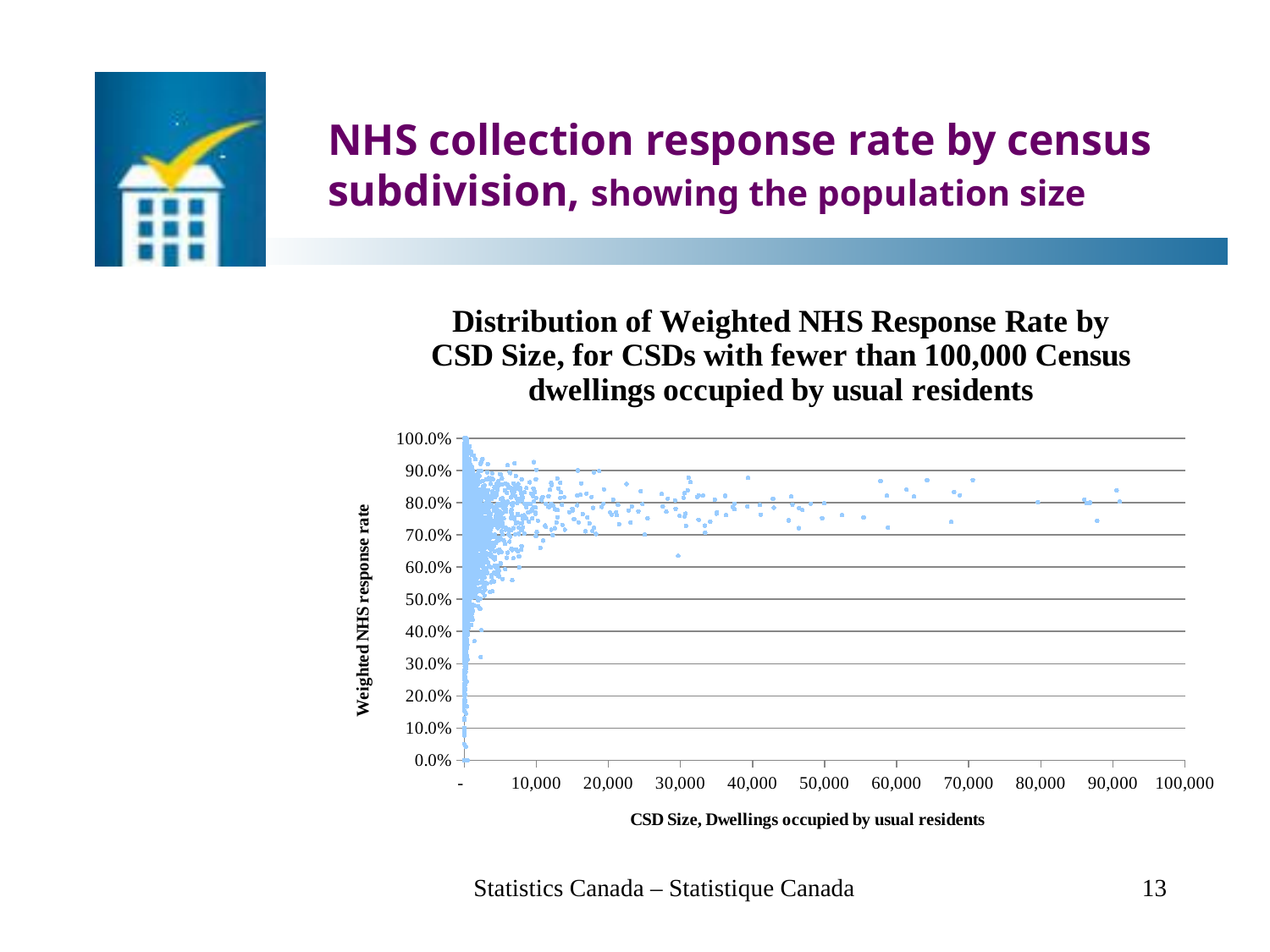
What is the label of the vertical axis of the chart? Weighted NHS response rate As CSD size increases along the x axis, does the spread of response rates widen or narrow? Narrow What is the label of the horizontal axis of the chart? CSD Size, Dwellings occupied by usual residents Are the points for CSDs with more than 50,000 dwellings above or below the 90.0% line on the response rate axis? below Are the lowest weighted NHS response rates found among small CSDs or large CSDs? Small CSDs What kind of chart is shown on the slide? Scatter plot Are the points for CSDs with more than 50,000 dwellings above or below the 60.0% line on the response rate axis? above